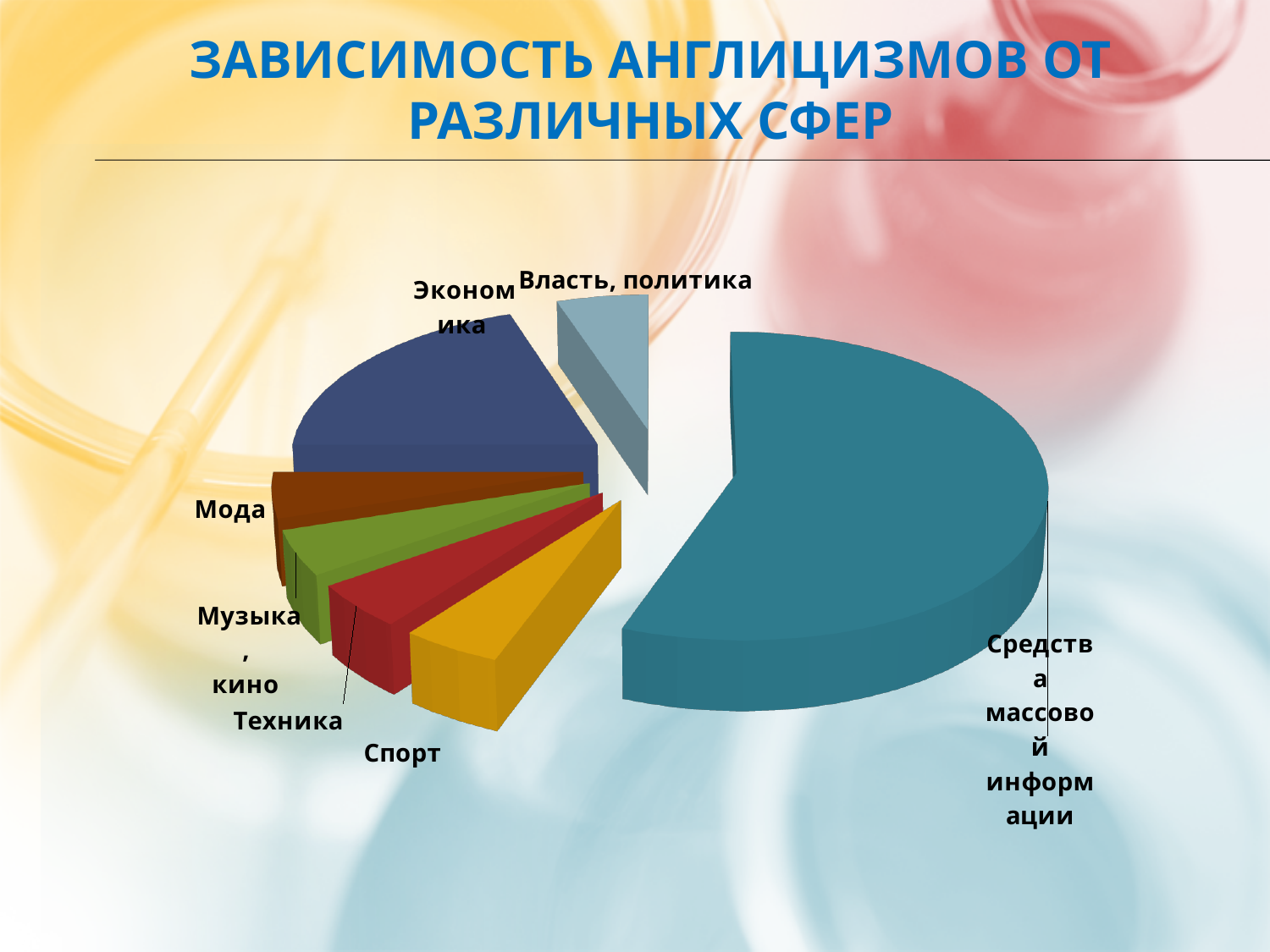
Which slice is larger: Экономика or Мода? Экономика What kind of chart is shown on the slide? Pie chart What is the title of the slide containing the pie chart? ЗАВИСИМОСТЬ АНГЛИЦИЗМОВ ОТ РАЗЛИЧНЫХ СФЕР How many categories (slices) does the pie chart have? 7 Which category has the largest slice of the pie chart? Средства массовой информации Which slice is larger: Средства массовой информации or Экономика? Средства массовой информации Which slice is larger: Экономика or Спорт? Экономика Which category is represented by the yellow slice? Спорт